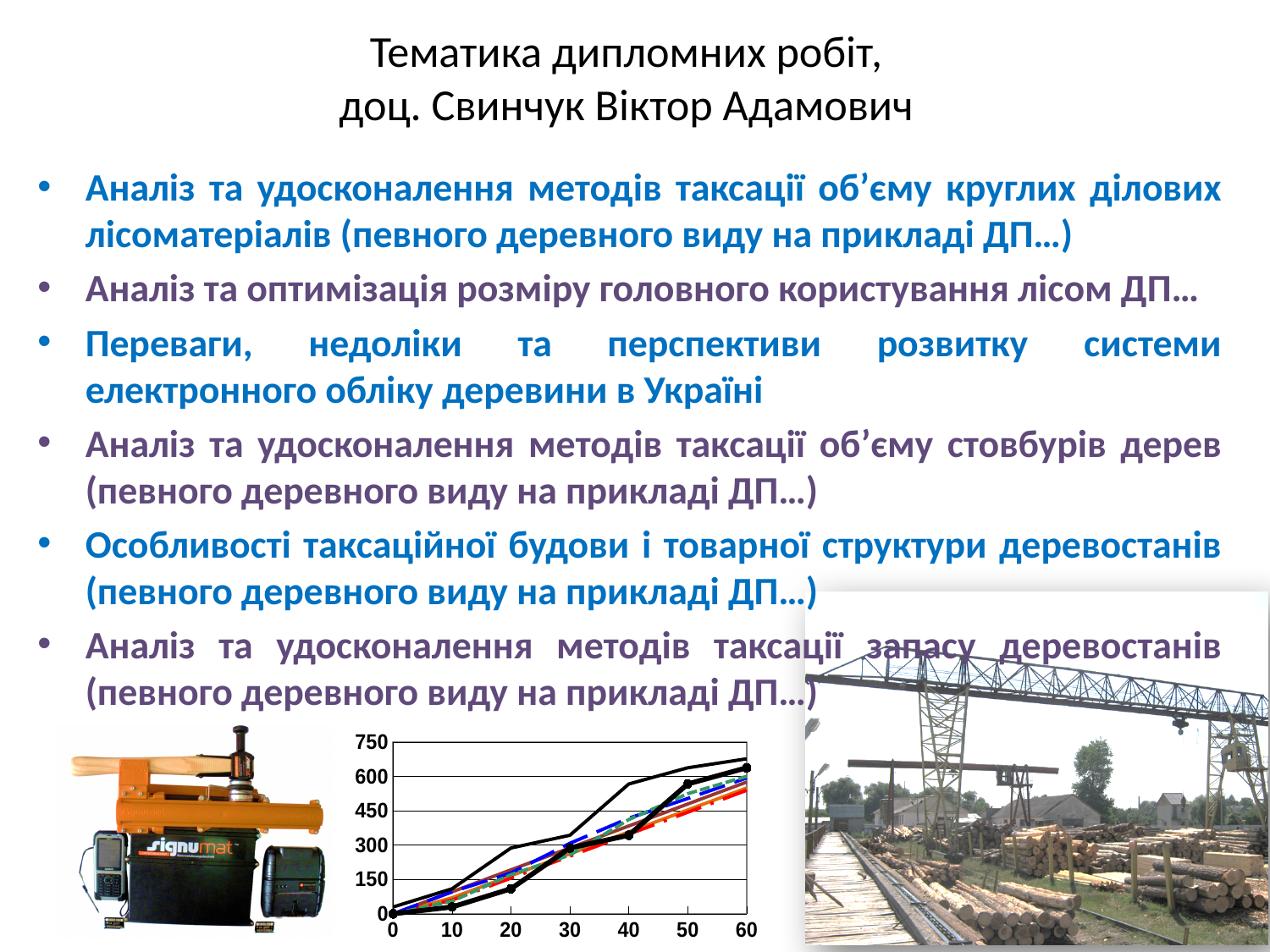
In the line chart, is the value of the black line with circle markers at x = 10 greater or less than 150? less In the line chart, what is the highest value shown on the y axis? 750 In the line chart, what is the largest value labelled on the x axis? 60 In the line chart, do the plotted values rise or fall as the x axis goes from 0 to 60? rise How many tick labels are shown on the x axis of the line chart? 7 In the line chart, is the value of the black line with circle markers at x = 40 greater or less than 300? greater In the line chart, is the value of the black line with circle markers at x = 60 greater or less than 600? greater What kind of chart is shown at the bottom of the slide? line chart